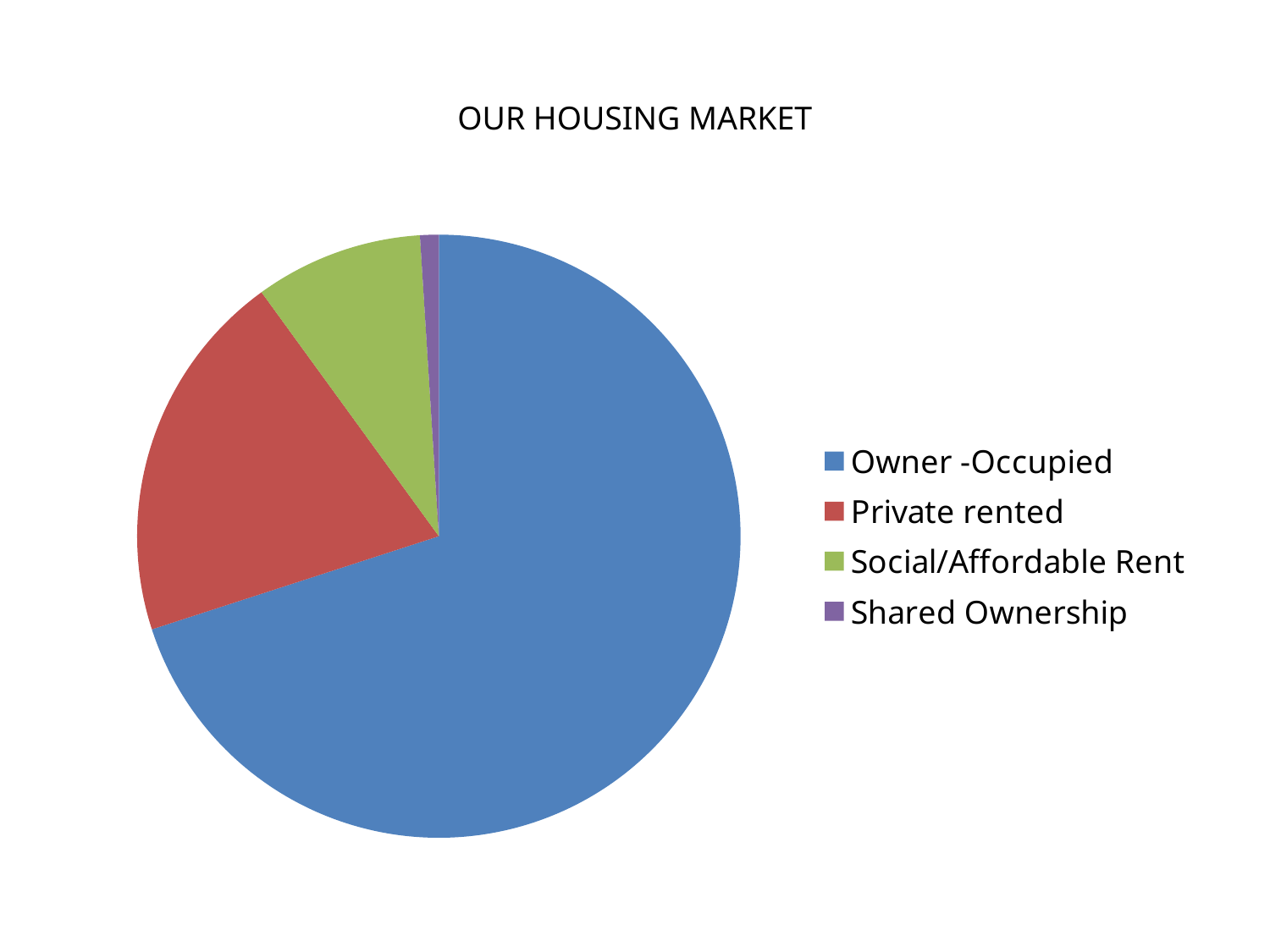
How many categories does the pie chart show? 4 Does the Owner -Occupied slice take up more or less than half of the pie? more Which slice is larger, Private rented or Social/Affordable Rent? Private rented What kind of chart is shown on the slide? pie chart Which category has the largest slice of the pie? Owner -Occupied What colour is the Private rented slice? red Which slice is larger, Owner -Occupied or Private rented? Owner -Occupied What is the title of the chart? OUR HOUSING MARKET Which slice is larger, Social/Affordable Rent or Shared Ownership? Social/Affordable Rent Which category has the smallest slice of the pie? Shared Ownership